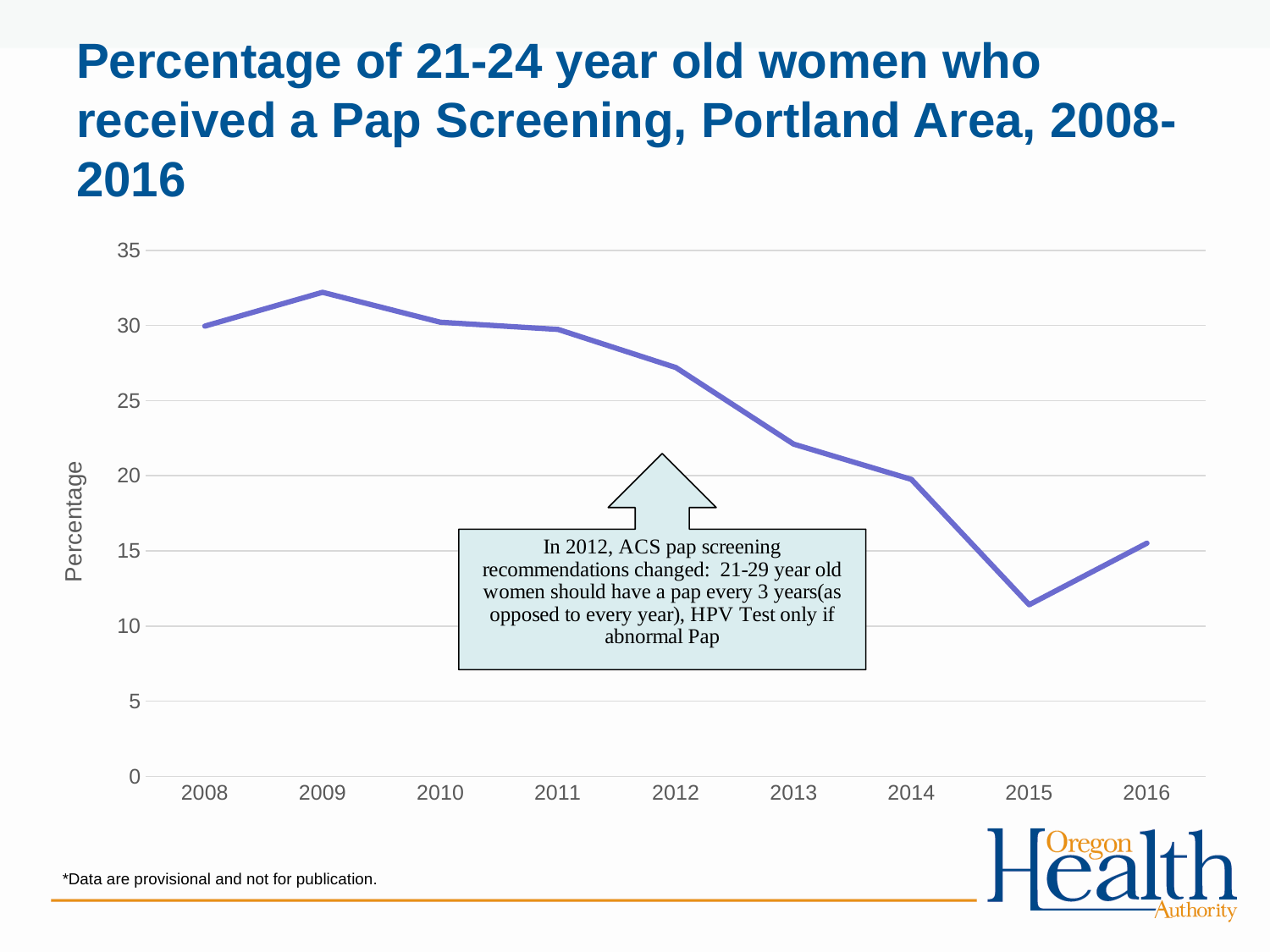
What kind of chart is shown on the slide? line chart Is the value for 2013 greater or less than 25? less How many years are plotted along the x axis? 9 Which year has a higher percentage, 2012 or 2013? 2012 Is the value for 2015 greater or less than 15? less Which year has the lowest percentage of 21-24 year old women who received a Pap screening? 2015 Which year has the highest percentage of 21-24 year old women who received a Pap screening? 2009 Is the value for 2009 greater or less than 30? greater Does the percentage generally rise or fall from 2008 to 2015? fall What is the label on the y axis? Percentage